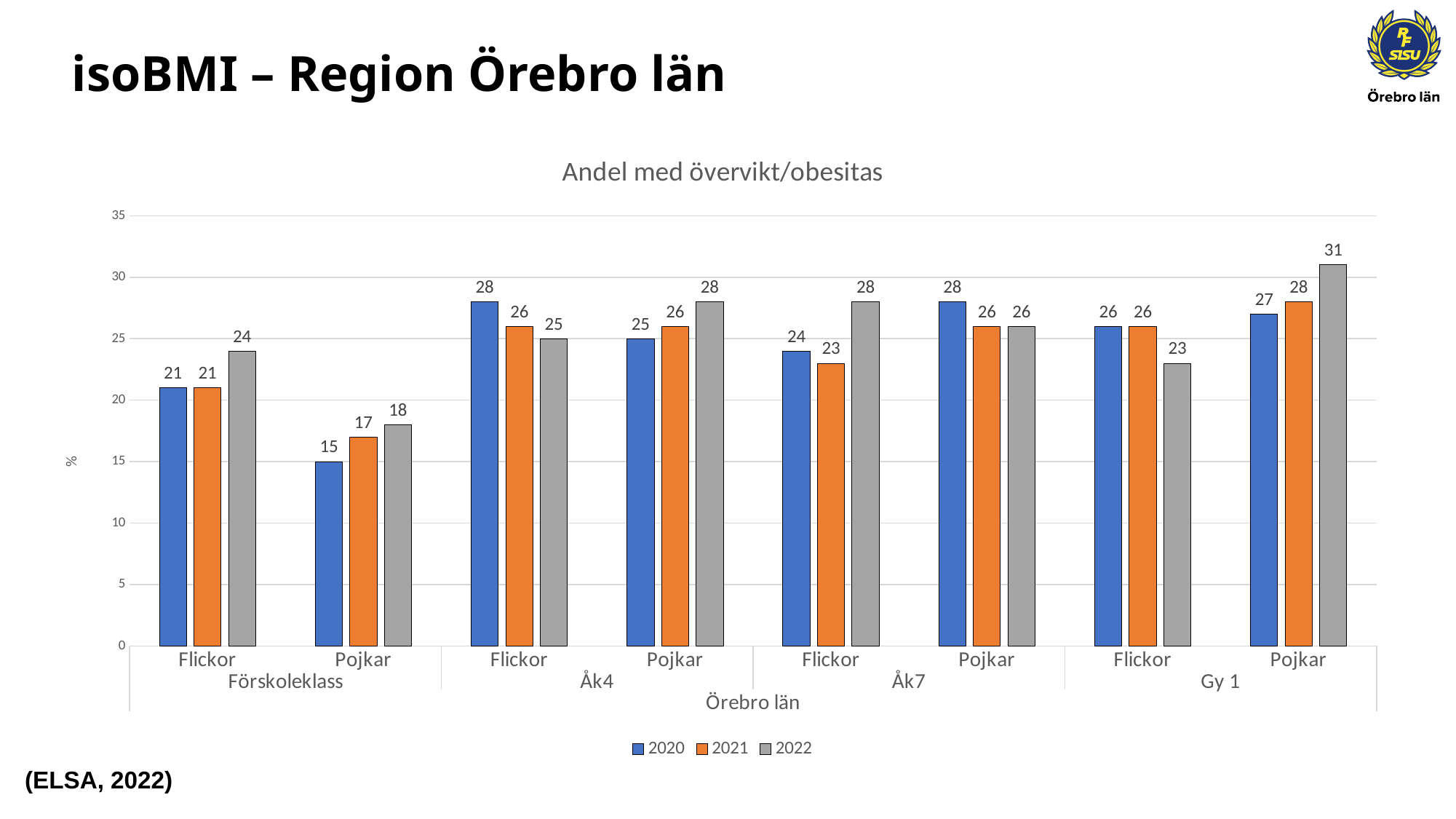
What is the value for Pojkar in Förskoleklass for 2021? 17 What is the value for Flickor in Åk7 for 2022? 28 Which category has the lowest value in the 2020 series? Pojkar, Förskoleklass What is the value for Pojkar in Gy 1 for 2022? 31 What is the title of the chart? Andel med övervikt/obesitas How many series does the legend list? 3 What is the difference between the 2022 and 2020 values for Pojkar in Förskoleklass? 3 Do the values for Pojkar in Förskoleklass rise or fall from 2020 to 2022? Rise Which is larger for Flickor in Åk4: the 2020 value or the 2022 value? 2020 Which category has the highest value in the 2022 series? Pojkar, Gy 1 What is the value for Flickor in Förskoleklass for 2020? 21 What kind of chart is shown on the slide? Bar chart